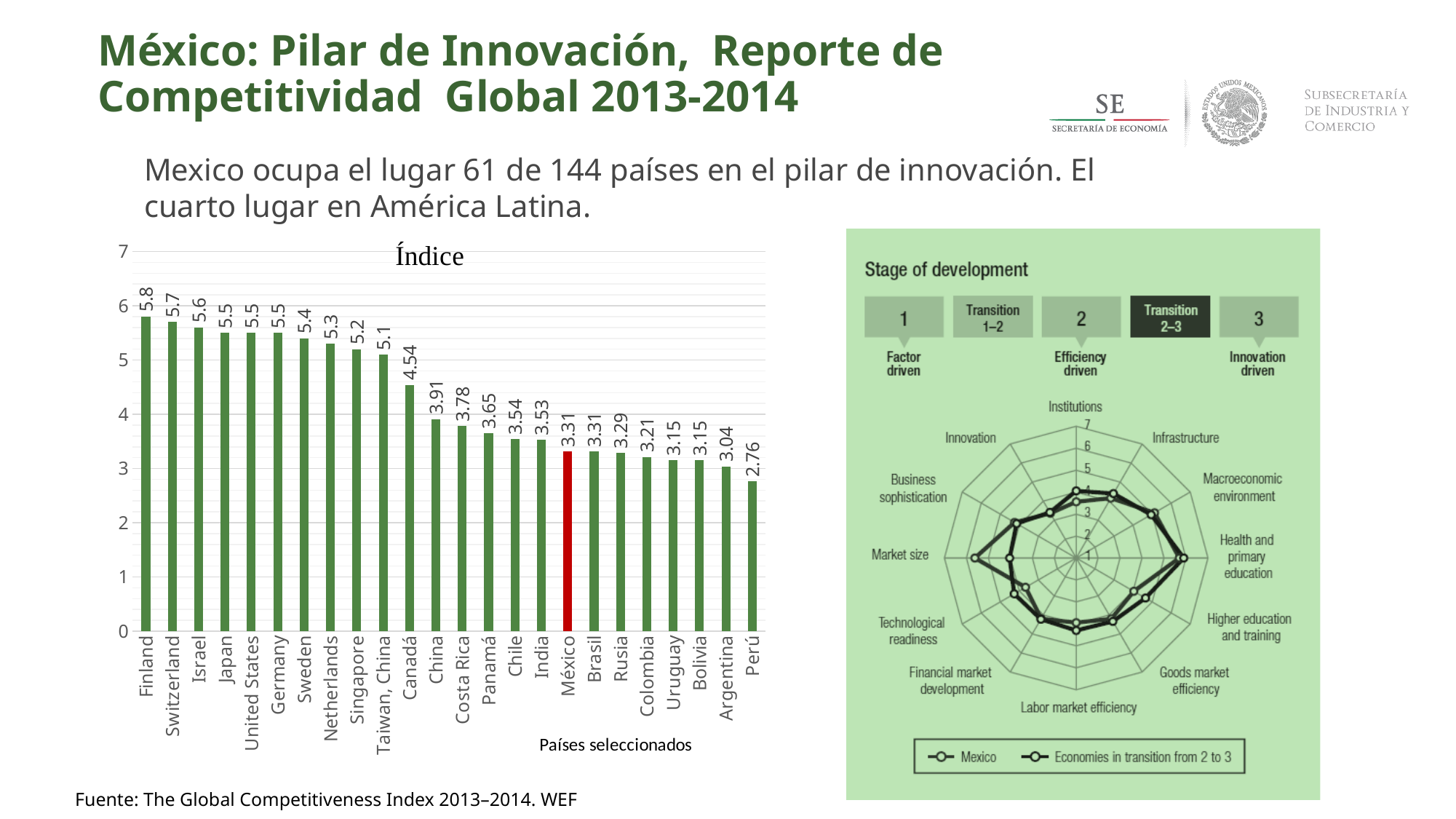
What kind of chart is the chart titled Índice on the left of the slide? Bar chart In the bar chart titled Índice, which has a larger value, Costa Rica or Colombia? Costa Rica In the bar chart titled Índice, what is the value for Canadá? 4.54 In the bar chart titled Índice, is the value for Canadá greater or less than 4? greater In the bar chart titled Índice, which country has the highest value? Finland In the bar chart titled Índice, what is the difference between the values for Finland and Perú? 3.04 In the bar chart titled Índice, do the values rise or fall from left to right? Fall In the radar chart on the right of the slide, how many series does the legend list? 2 How many countries are shown in the bar chart titled Índice? 24 In the bar chart titled Índice, what is the value for México? 3.31 In the bar chart titled Índice, which country has the lowest value? Perú In the bar chart titled Índice, what is the difference between the values for Canadá and China? 0.63